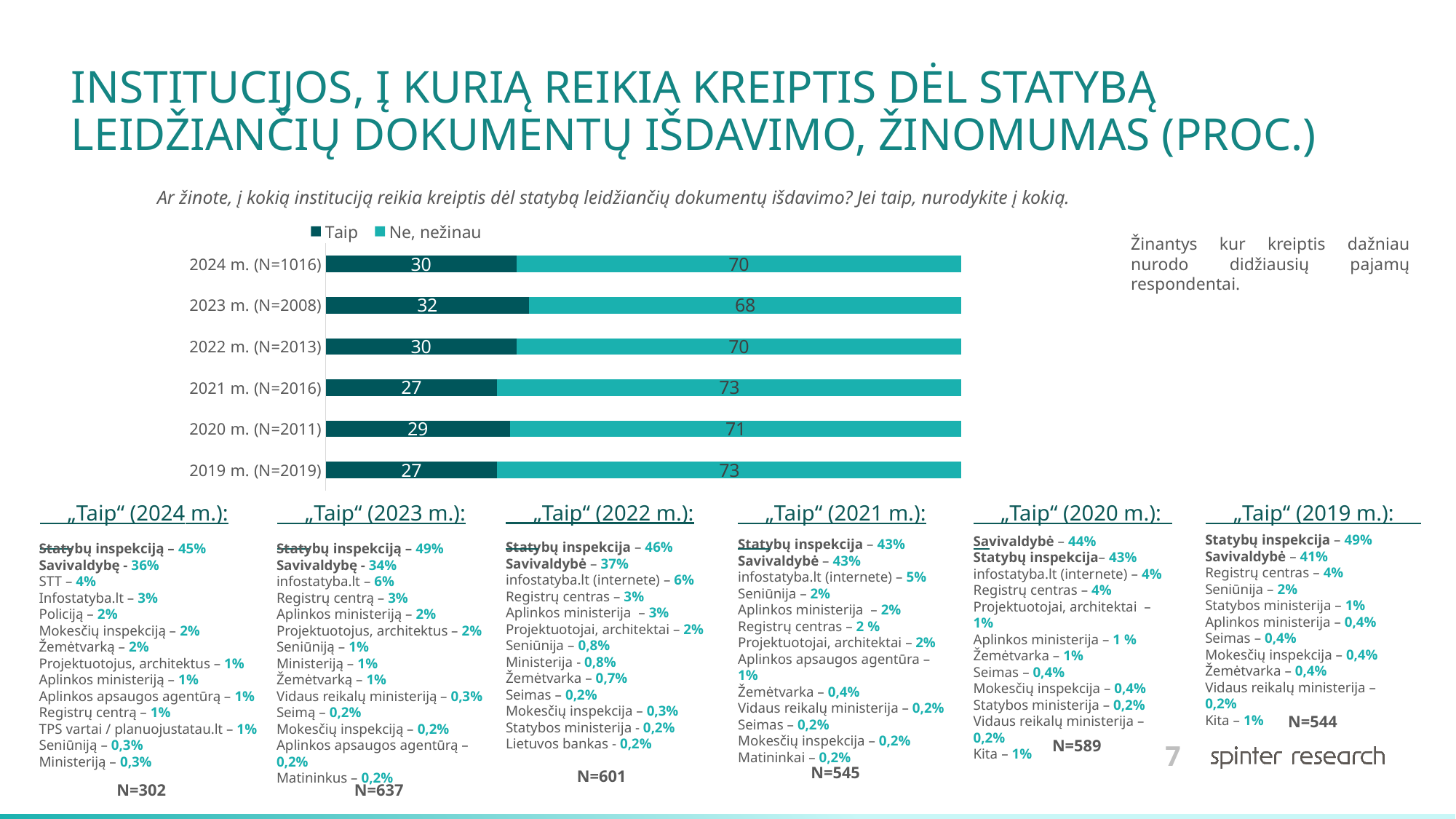
What is the "Taip" value for 2020 m. (N=2011)? 29 Which year has the lowest "Ne, nežinau" value? 2023 m. (N=2008) What is the value for "Taip" in 2024 m. (N=1016)? 30 How many series does the chart legend list? 2 Which year has the highest "Taip" value? 2023 m. (N=2008) What is the total of the stacked bar for 2019 m. (N=2019)? 100 What is the difference between the "Ne, nežinau" and "Taip" values for 2020 m. (N=2011)? 42 Is the "Taip" value larger in 2022 m. (N=2013) or in 2021 m. (N=2016)? 2022 m. (N=2013) What are the two legend entries of the chart? Taip; Ne, nežinau How many years (categories) are shown in the chart? 6 What is the value for "Ne, nežinau" in 2021 m. (N=2016)? 73 What kind of chart is shown on the slide? Stacked bar chart